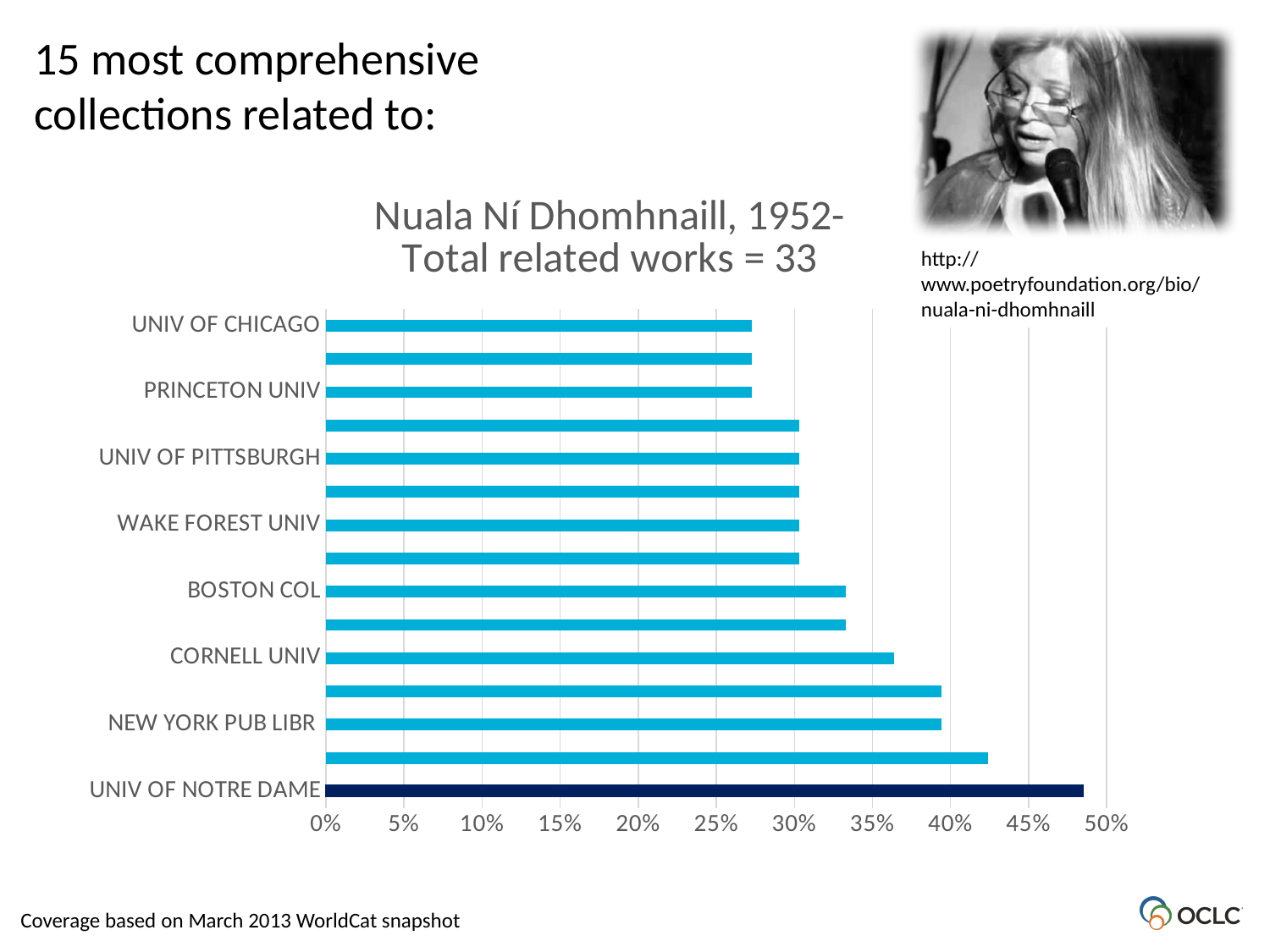
According to the chart title, what is the total number of related works? 33 Is the value for UNIV OF CHICAGO greater or less than 30%? less Is the value for NEW YORK PUB LIBR greater or less than 35%? greater Which has the larger value, PRINCETON UNIV or NEW YORK PUB LIBR? NEW YORK PUB LIBR Is the value for CORNELL UNIV greater or less than 35%? greater Which has the larger value, CORNELL UNIV or BOSTON COL? CORNELL UNIV Which institution has the highest value in the chart? UNIV OF NOTRE DAME What kind of chart is shown on the slide? bar chart How many bars are plotted in the chart? 15